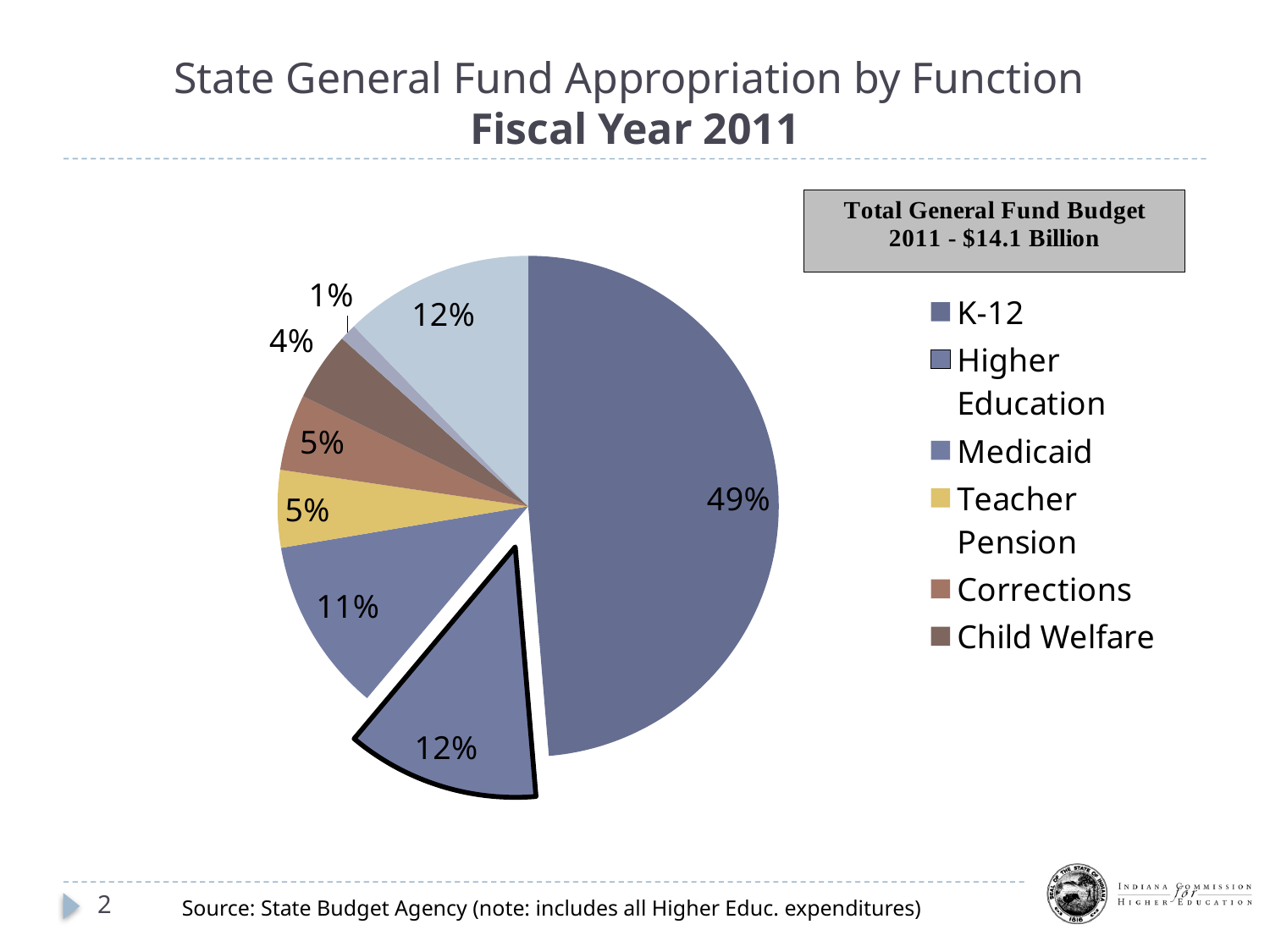
Which has the larger share, Medicaid or Higher Education? Higher Education What share of the State General Fund appropriation goes to Teacher Pension? 5% How many slices does the pie chart have? 8 What share of the State General Fund appropriation goes to Higher Education? 12% What share of the State General Fund appropriation goes to Medicaid? 11% Which function receives the largest share of the State General Fund appropriation? K-12 What share of the State General Fund appropriation goes to K-12? 49% What share of the State General Fund appropriation goes to Child Welfare? 4% What is the total General Fund budget for 2011 stated on the slide? $14.1 Billion What type of chart is shown on the slide? pie chart How many percentage points larger is the K-12 share than the Higher Education share? 37 How many entries does the legend list? 6